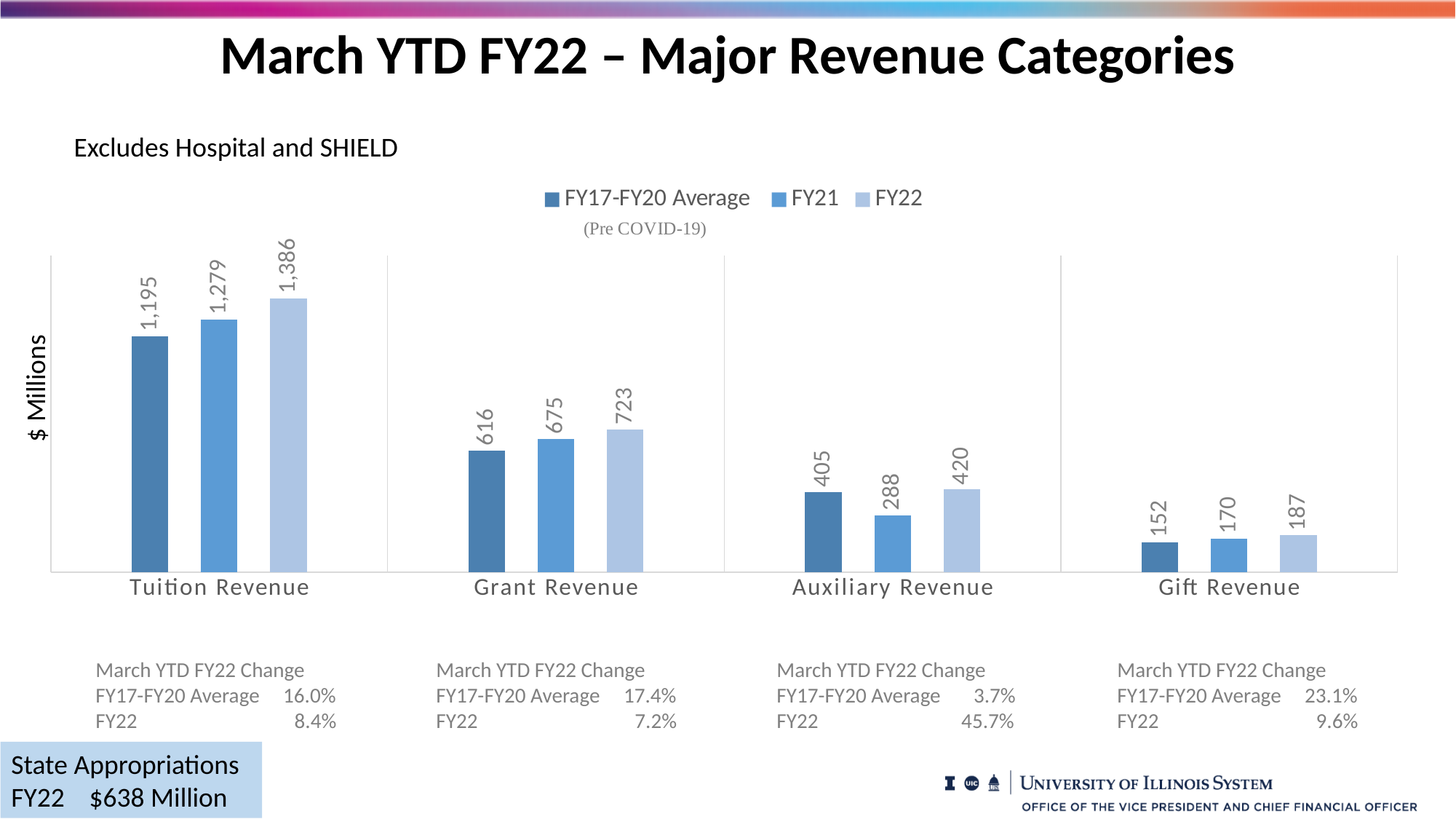
What is the difference between the FY17-FY20 Average and FY21 values for Auxiliary Revenue? 117 How many revenue categories are shown on the x axis? 4 What is the FY21 value for Auxiliary Revenue? 288 Which category has the lowest FY21 value? Gift Revenue For Auxiliary Revenue, which is larger: the FY17-FY20 Average or the FY21 value? FY17-FY20 Average What is the FY17-FY20 Average value for Gift Revenue? 152 What is the y-axis label of the chart? $ Millions What is the difference between the FY22 and FY21 values for Grant Revenue? 48 Which category has the highest FY22 value? Tuition Revenue How many series does the legend list? 3 What is the FY22 value for Tuition Revenue? 1,386 What kind of chart is shown on the slide? Bar chart